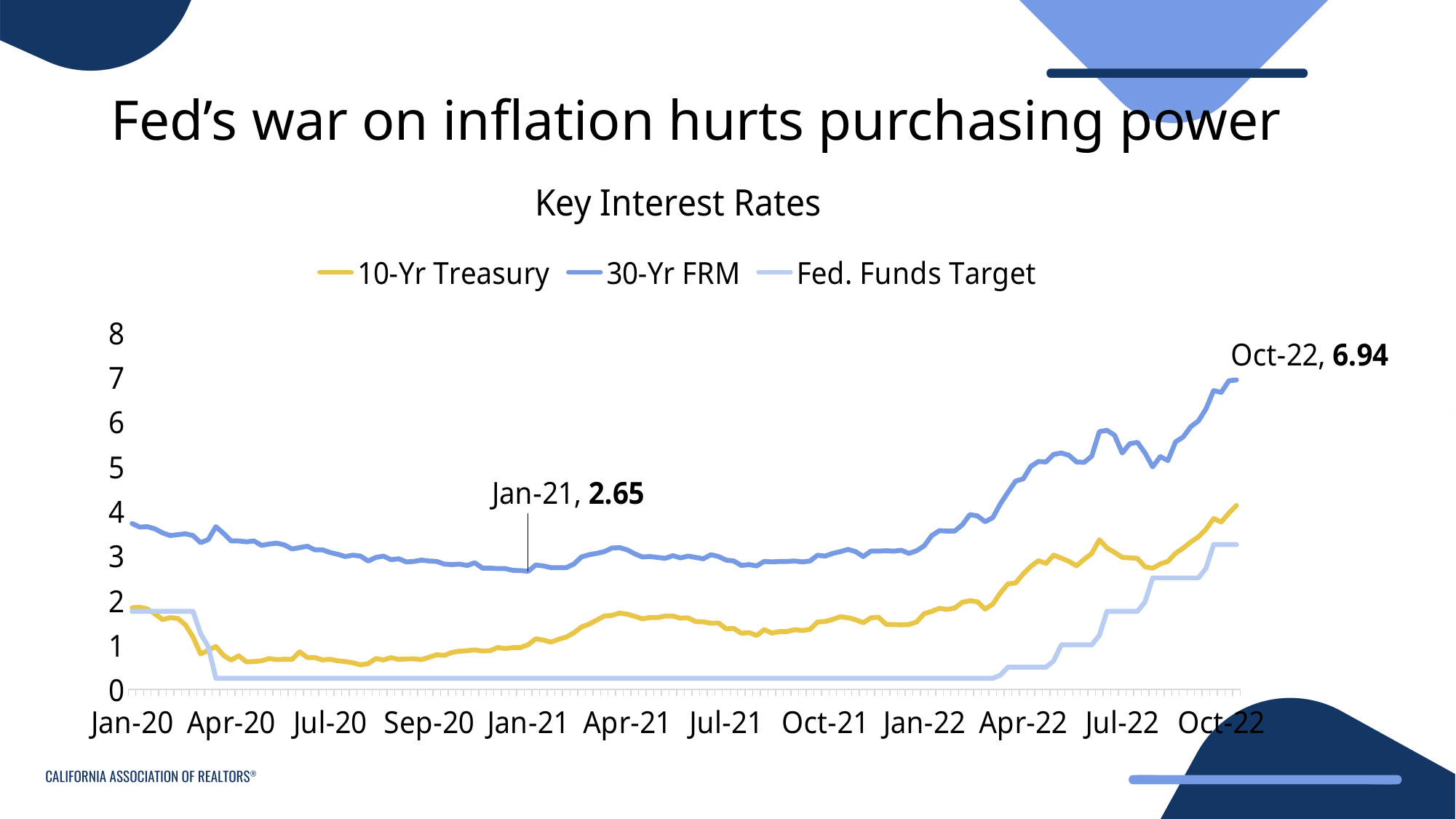
Which series has the highest value in Oct-22? 30-Yr FRM Which series has the lowest value in Jan-21? Fed. Funds Target Does the 30-Yr FRM line rise or fall between Jan-21 and Oct-22? Rise Is the value for the 10-Yr Treasury in Oct-22 greater or less than 3? greater Is the value for the Fed. Funds Target in Jan-21 greater or less than 1? less What was the 30-Yr FRM rate in Jan-21 according to the data label? 2.65 What is the title of the chart? Key Interest Rates In Oct-22, which is larger: the 30-Yr FRM or the 10-Yr Treasury? 30-Yr FRM What was the 30-Yr FRM rate in Oct-22 according to the data label? 6.94 What kind of chart is shown on the slide? Line chart How many series does the chart's legend list? 3 By how much did the 30-Yr FRM rate rise between Jan-21 (2.65) and Oct-22 (6.94)? 4.29